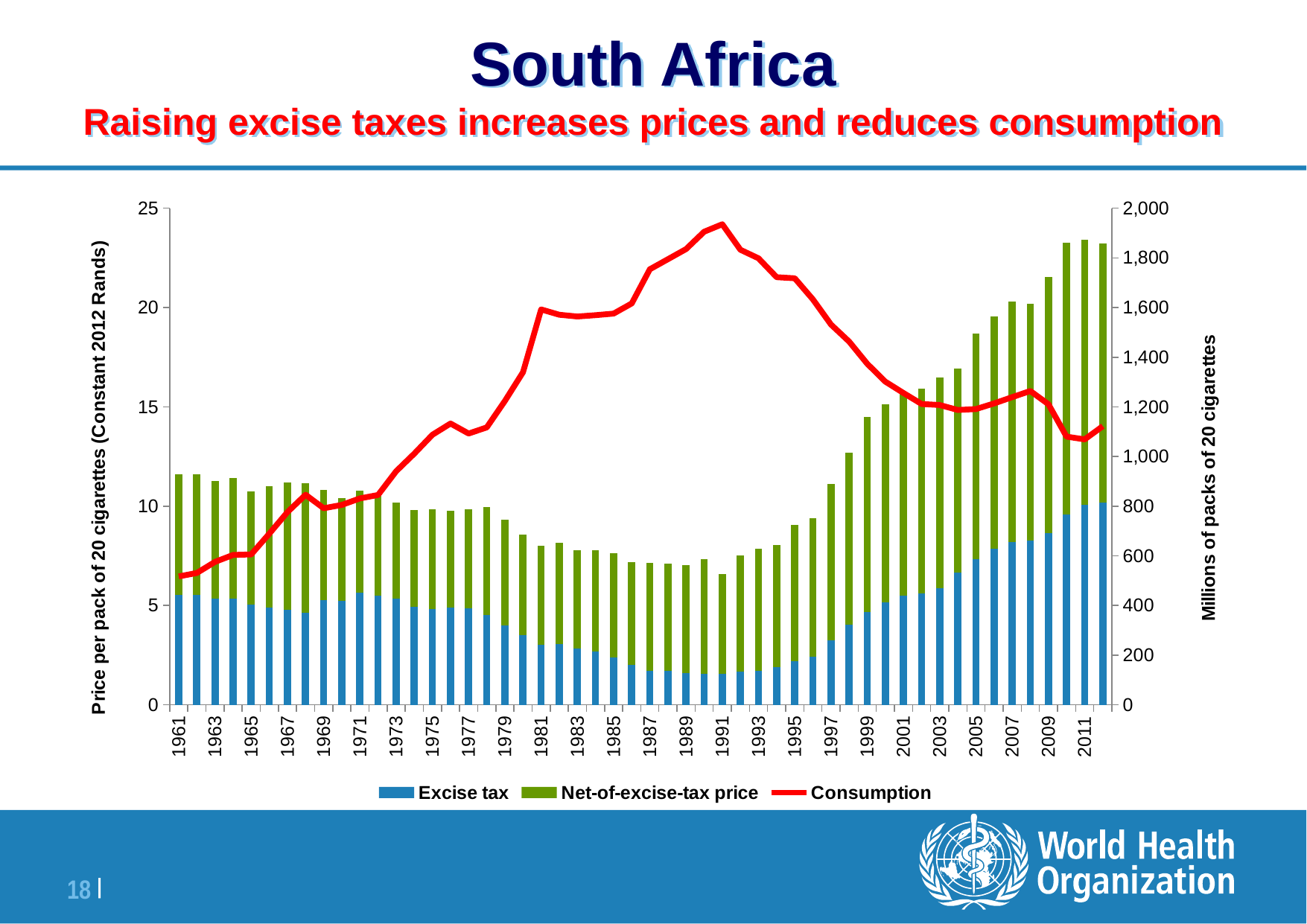
Which year has the higher Consumption value, 1981 or 2001? 1981 Is the Consumption value in 1991 greater or less than 1,800? greater Is the total price per pack (top of the stacked bar) in 2010 greater or less than 20? greater How many series does the legend list? 3 Is the Consumption value in 1961 greater or less than 600? less What kind of chart is shown on the slide? A stacked bar chart combined with a line Does the Consumption line rise or fall between 1991 and 2011? fall In which year is the Consumption line at its lowest point? 1961 Which series is drawn as a red line? Consumption In which year does the Consumption line reach its highest point? 1991 What is the label of the right-hand vertical axis? Millions of packs of 20 cigarettes